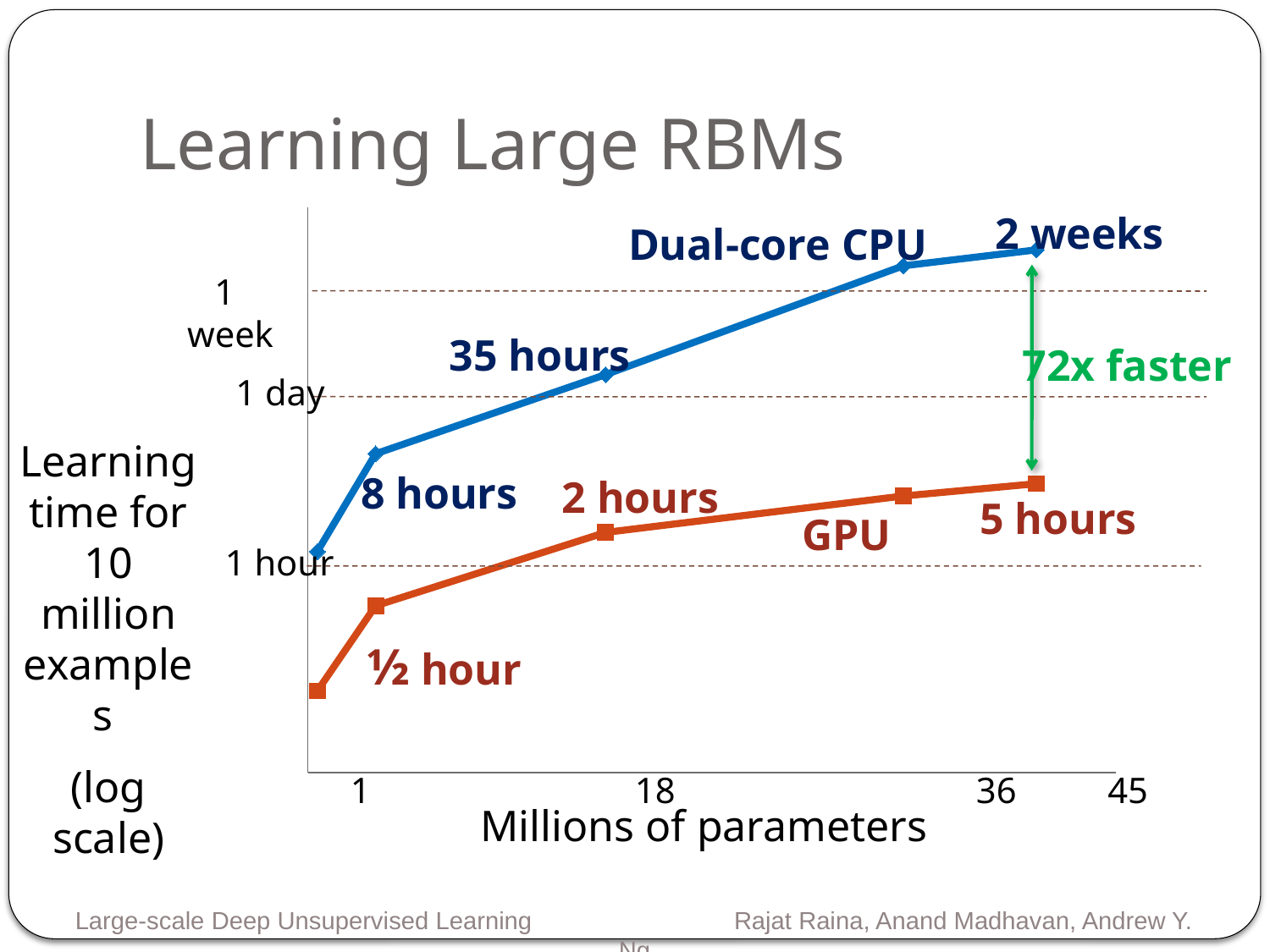
What are the names of the two series plotted on the chart? Dual-core CPU and GPU What learning time is labeled for the Dual-core CPU at 18 million parameters? 35 hours What is the title of the chart's x axis? Millions of parameters What kind of chart is shown on the slide? line chart What is the longest learning time labeled on the GPU line? 5 hours Does the learning time rise or fall as the number of parameters increases along the x axis? rise What is the longest learning time labeled on the Dual-core CPU line? 2 weeks What is the shortest learning time labeled on the GPU line? ½ hour What learning time is labeled for the GPU at 18 million parameters? 2 hours Which series has the higher learning time at 36 million parameters, Dual-core CPU or GPU? Dual-core CPU Is the GPU learning time at 36 million parameters greater or less than 1 day? less How many data series are plotted on the chart? 2